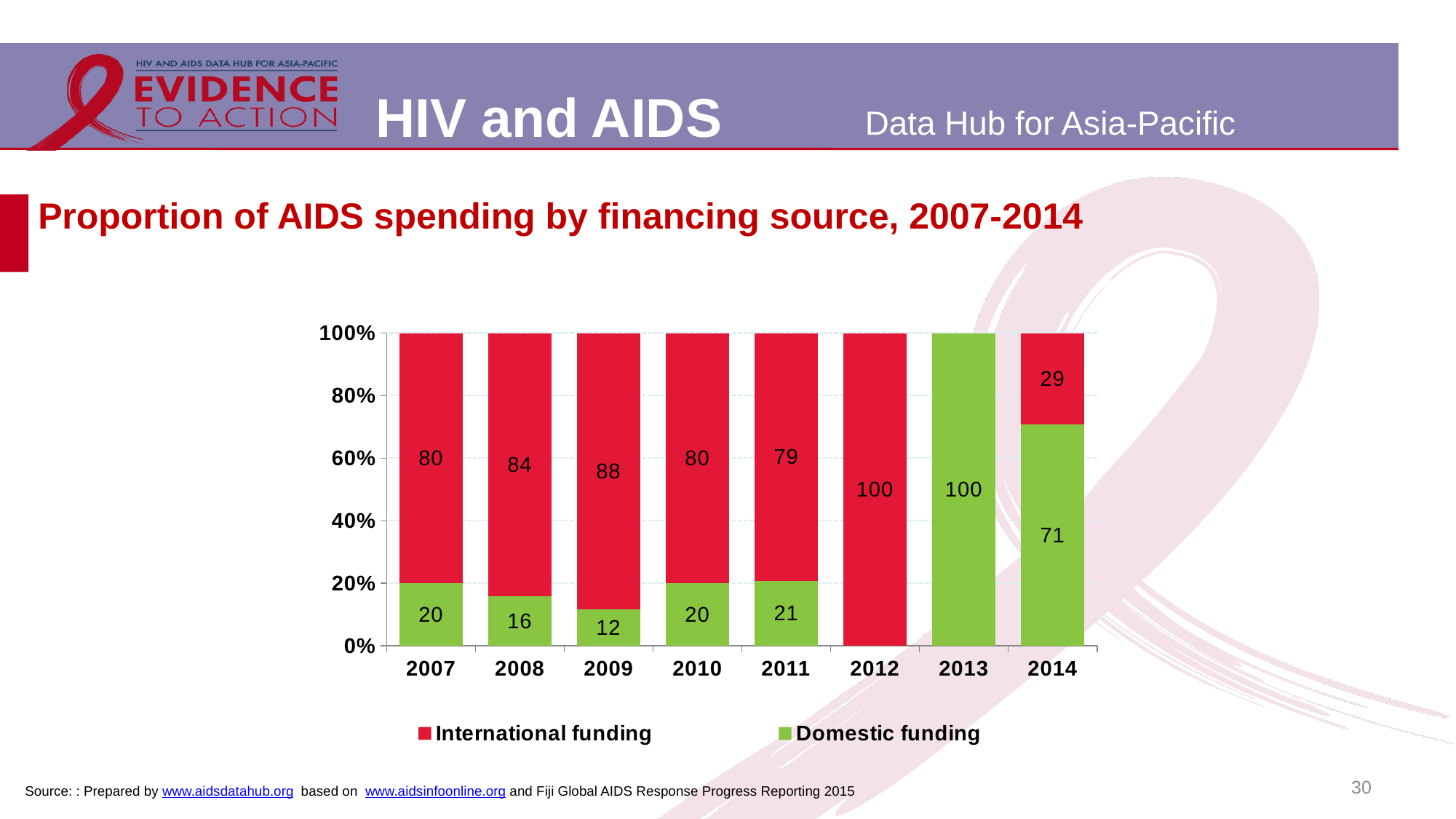
What is the difference between International funding and Domestic funding in 2014? 42 What is the value for Domestic funding in 2014? 71 Among the years where Domestic funding is shown, in which year is it the lowest? 2009 What is the value for International funding in 2009? 88 How many series does the legend list? 2 What is the value for Domestic funding in 2011? 21 In which year is the Domestic funding share the highest? 2013 What is the total of the stacked bar for 2010 (International funding plus Domestic funding)? 100 Which is larger in 2008: International funding or Domestic funding? International funding How many years are shown on the x axis? 8 Which colour represents Domestic funding in the chart? Green What kind of chart is shown on the slide? Stacked bar chart